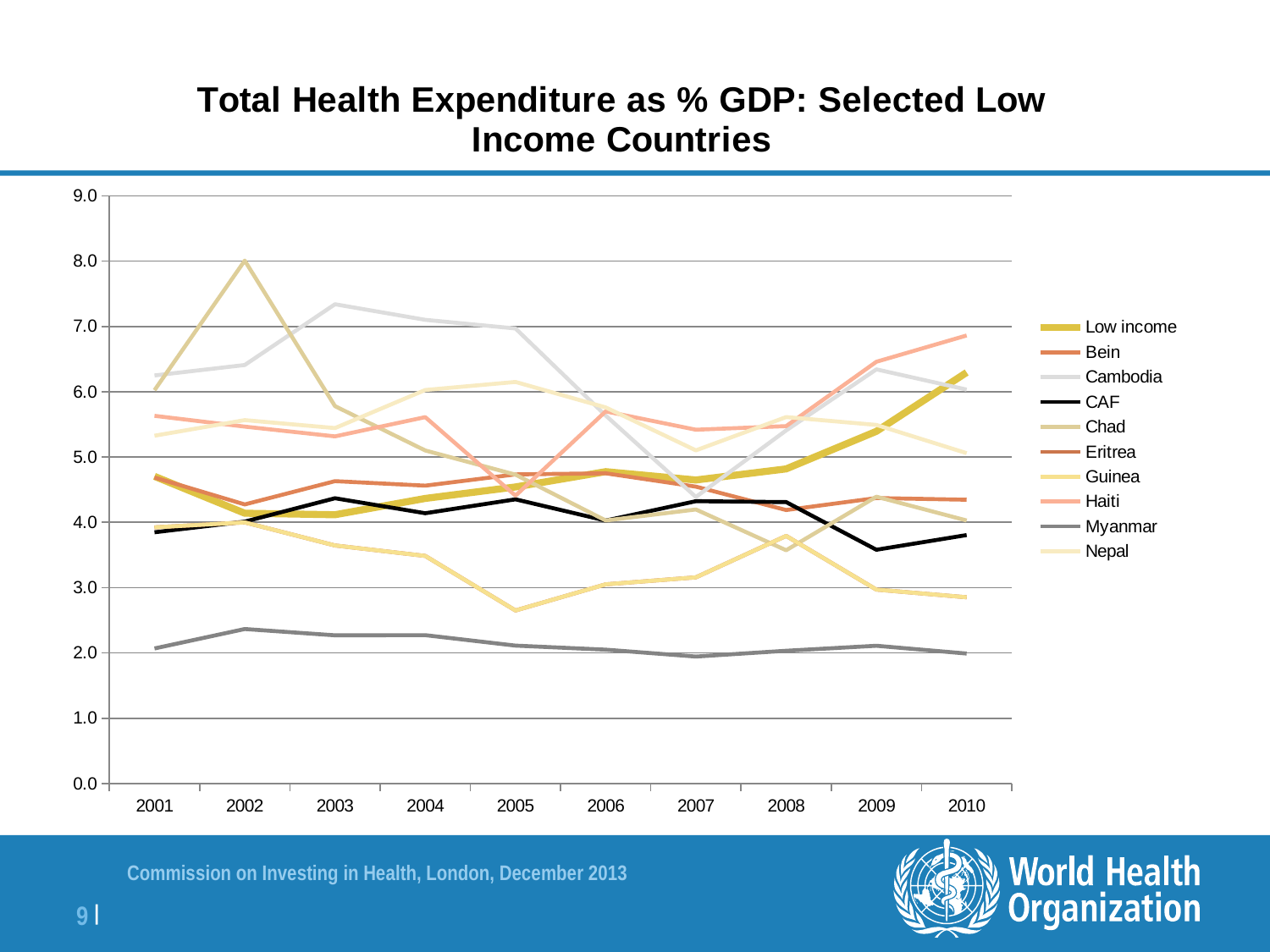
Is the value for Chad in 2002 greater or less than 7.0? greater Is the value for CAF in 2009 greater or less than 4.0? less In 2002, which is larger: the value for Chad or the value for Cambodia? Chad Does the Low income series rise or fall between 2007 and 2010? Rise Is the value for Myanmar in 2010 greater or less than 3.0? less How many years are shown along the x axis? 10 What kind of chart is shown on the slide? Line chart Which country has the lowest total health expenditure as % GDP in 2010? Myanmar Which series has the highest value in 2010? Haiti What is the title of the chart? Total Health Expenditure as % GDP: Selected Low Income Countries Which series has the highest value in 2002? Chad How many series does the legend list? 10